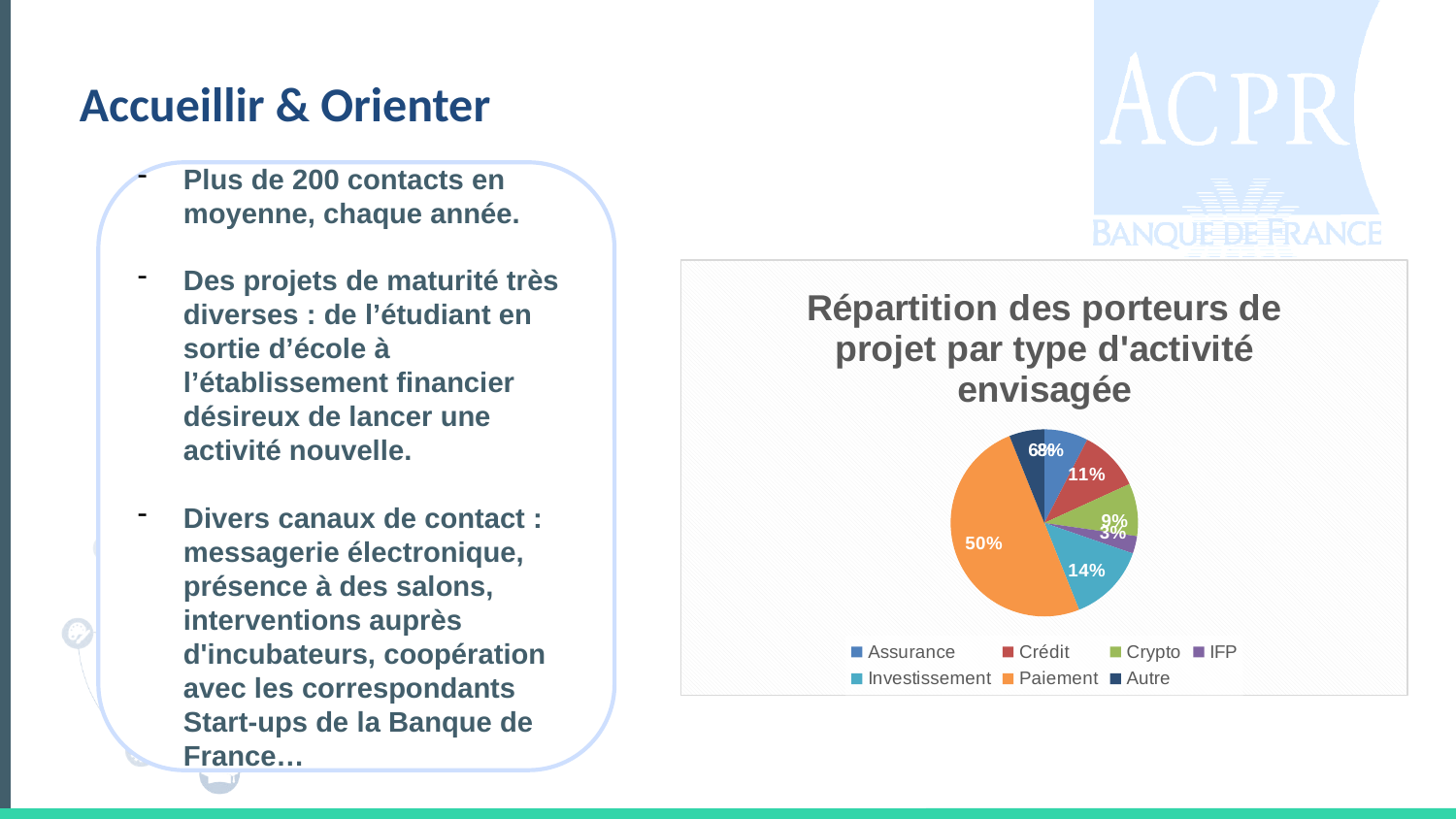
What colour is the Paiement slice? orange What is the difference between the share for Paiement and the share for Investissement? 36% What is the title of the chart? Répartition des porteurs de projet par type d'activité envisagée What kind of chart is shown on the slide? pie chart Which category has the smallest share of the pie? IFP What percentage is shown for Crypto? 9% Which category has the largest share of the pie? Paiement What percentage is shown for Investissement? 14% What percentage is shown for Crédit? 11% What percentage is shown for Paiement? 50% How many categories does the legend list? 7 Which is larger, the share for Investissement or the share for Crédit? Investissement